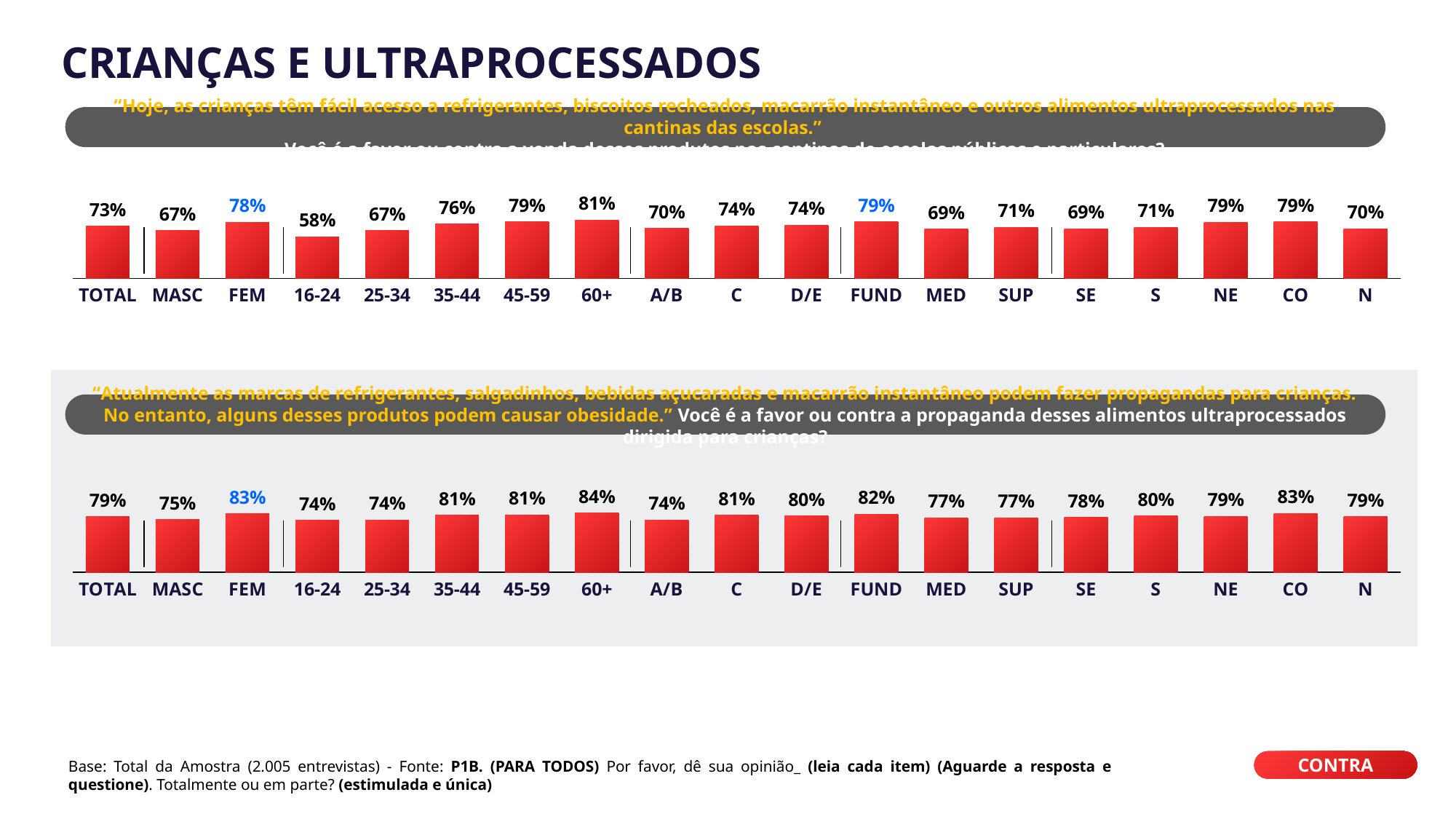
In the bottom chart, which category has the highest value? 60+ In the top chart, which category has the lowest value? 16-24 In the top chart, how many categories are shown on the x axis? 19 In the top chart, what is the value for D/E? 74% In the top chart, what is the difference between the values for FEM and MASC? 11% What kind of chart is the bottom chart? Bar chart In the bottom chart, what is the difference between the values for 60+ and 16-24? 10% In the top chart, which category has the highest value? 60+ In the bottom chart, what is the value for FUND? 82% In the bottom chart, which is larger, the value for FEM or the value for MASC? FEM In the top chart, what is the value for TOTAL? 73% What colour are the bars in both charts? Red